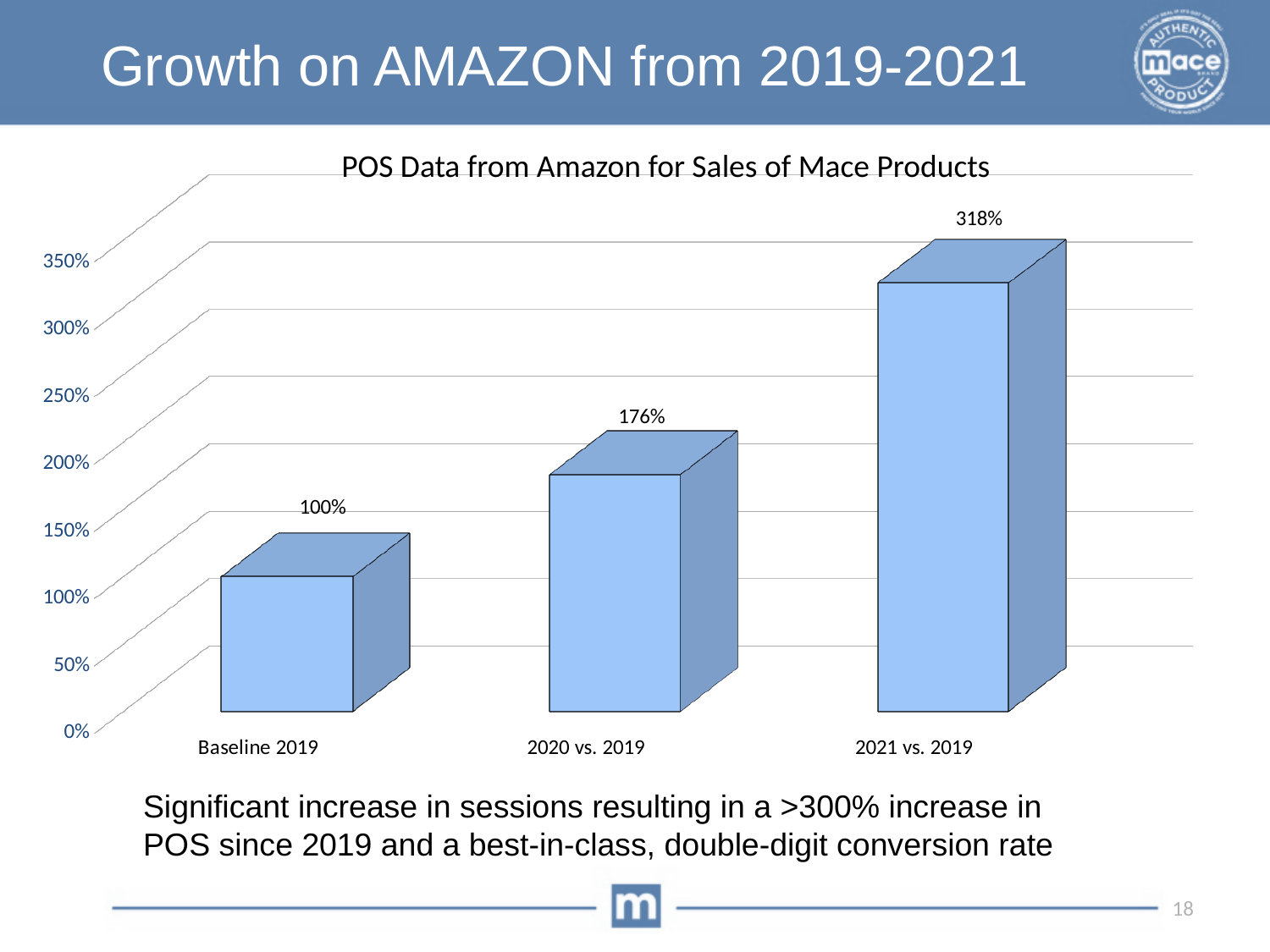
Which is larger, the value for 2020 vs. 2019 or the value for 2021 vs. 2019? 2021 vs. 2019 What is the title of the chart? POS Data from Amazon for Sales of Mace Products What is the value for 2020 vs. 2019? 176% What kind of chart is shown on the slide? bar chart What is the difference between the values for 2020 vs. 2019 and Baseline 2019? 76% Which category has the lowest value? Baseline 2019 How many categories are shown on the x axis? 3 What is the value for Baseline 2019? 100% Is the value for 2021 vs. 2019 greater or less than 300%? greater What is the difference between the values for 2021 vs. 2019 and 2020 vs. 2019? 142% Which category has the highest value? 2021 vs. 2019 What is the value for 2021 vs. 2019? 318%